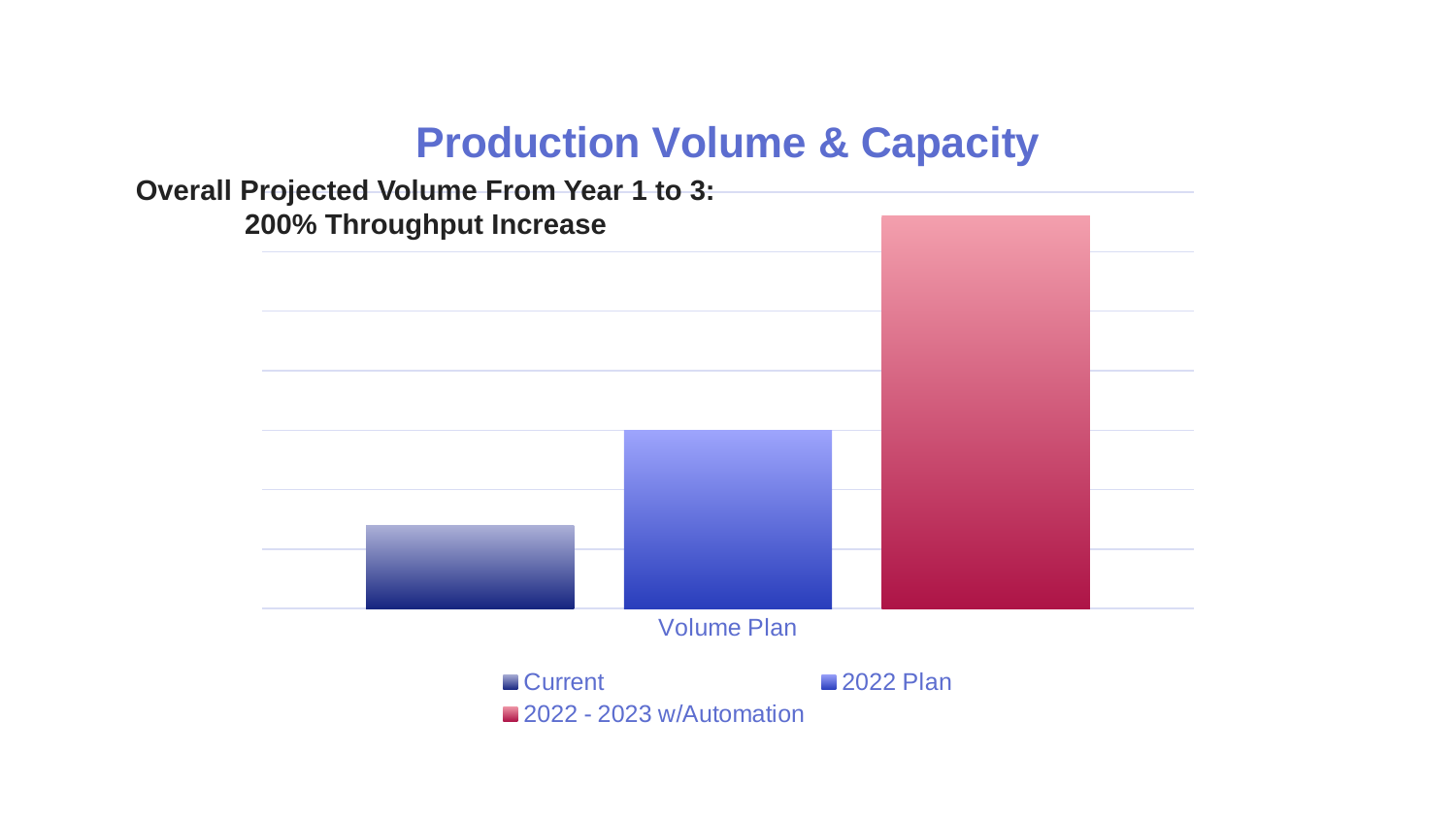
What kind of chart is shown on the slide? bar chart Which series has the highest bar? 2022 - 2023 w/Automation Which is larger, the bar for Current or the bar for 2022 Plan? 2022 Plan What is the label of the category on the x axis? Volume Plan What is the title of the chart? Production Volume & Capacity How many categories are shown on the x axis? 1 Which series has the lowest bar? Current Which is larger, the bar for 2022 Plan or the bar for 2022 - 2023 w/Automation? 2022 - 2023 w/Automation How many series does the legend list? 3